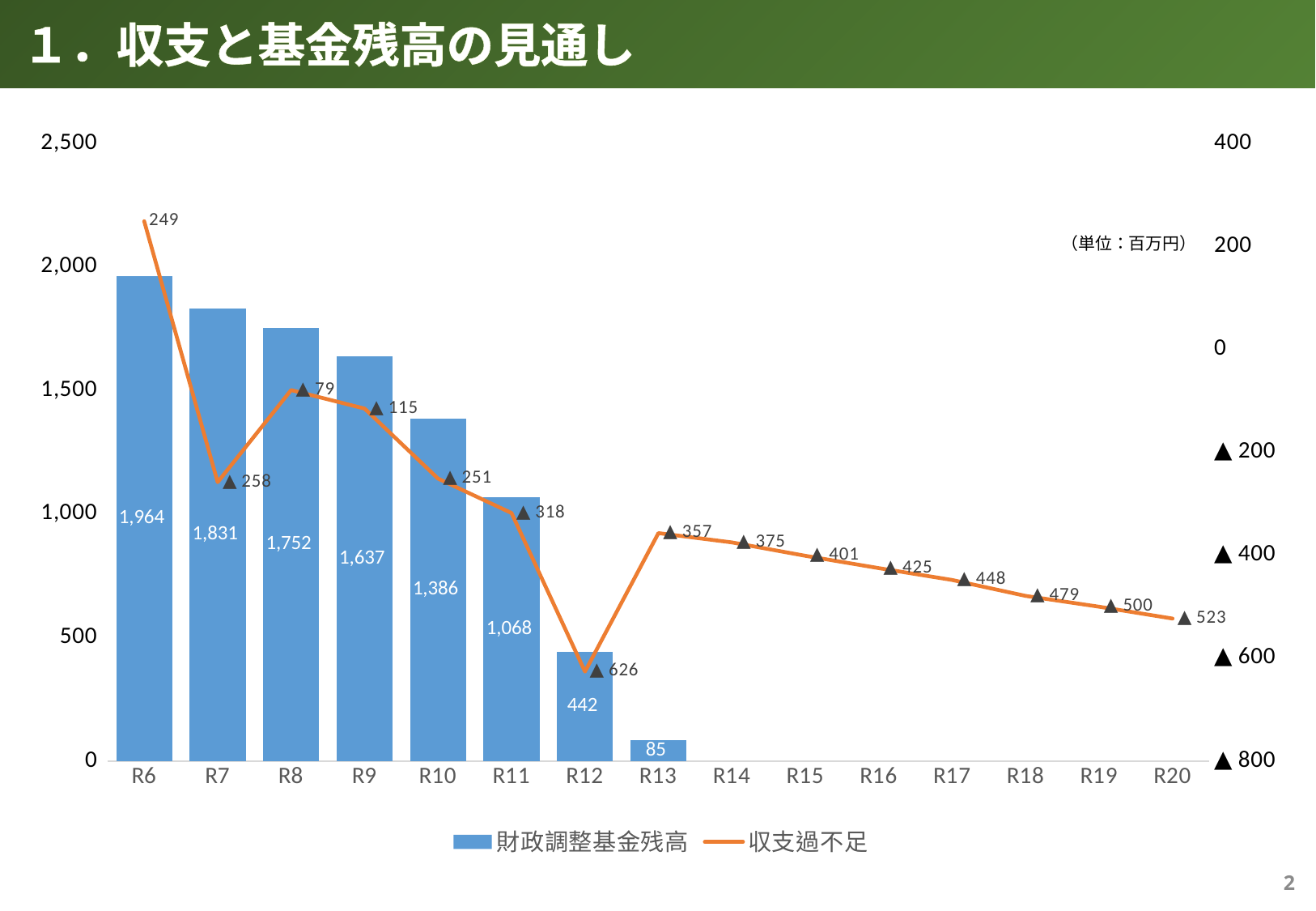
What is the value of 財政調整基金残高 for R9? 1,637 What kind of chart is shown on the slide? Combination bar and line chart Which year has the highest 財政調整基金残高? R6 What is the value of 収支過不足 for R12? ▲626 Do the 財政調整基金残高 bars rise or fall from R6 to R13? Fall Which year has the lowest 財政調整基金残高 among the bars shown? R13 How many years are shown on the x axis? 15 What is the difference between the 財政調整基金残高 for R6 and R7? 133 Which is larger, the 財政調整基金残高 for R10 or for R11? R10 How many series does the legend list? 2 What is the value of 収支過不足 for R20? ▲523 What unit is stated for the values on the chart? 百万円